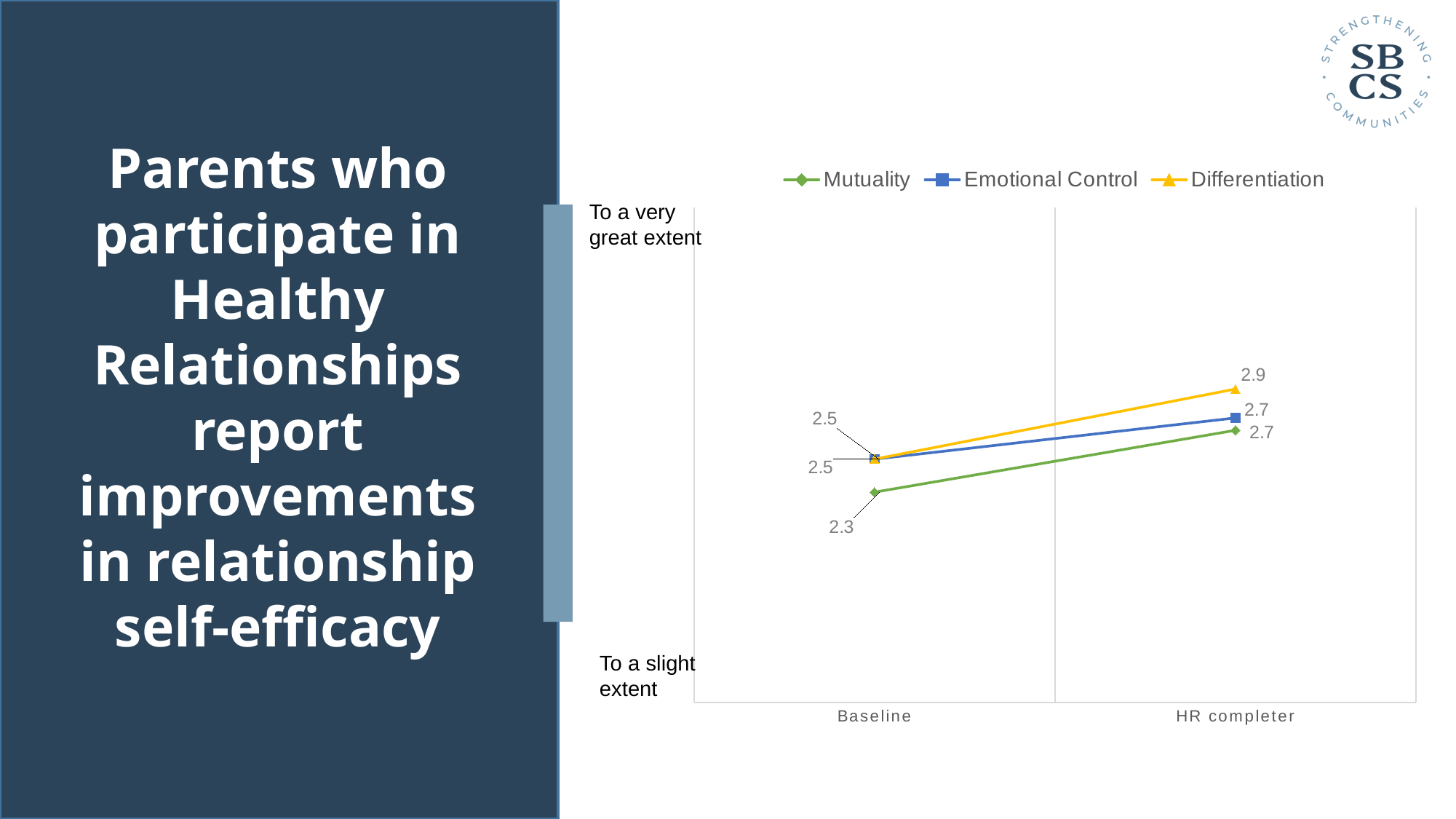
How many series does the legend list? 3 Which series has the highest value at HR completer? Differentiation What is the Mutuality value at Baseline? 2.3 How many categories are shown on the x axis? 2 What type of chart is shown on the slide? line chart What is the Mutuality value at HR completer? 2.7 Which series is drawn in green? Mutuality Do the Differentiation values rise or fall from Baseline to HR completer? rise What is the Emotional Control value at HR completer? 2.7 Which series has the lowest value at Baseline? Mutuality By how much does the Mutuality value increase from Baseline to HR completer? 0.4 What is the Differentiation value at HR completer? 2.9